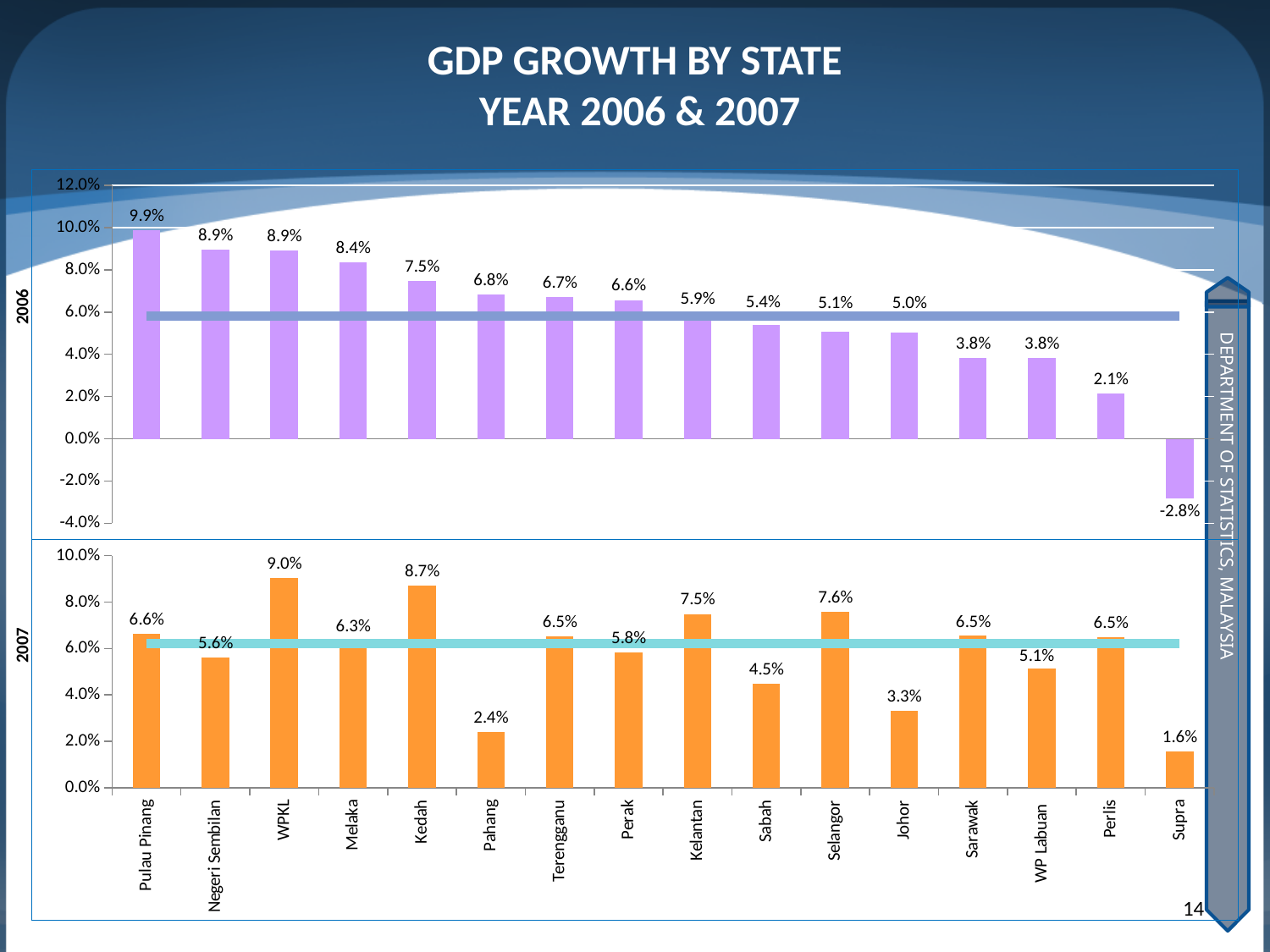
In the 2007 chart, which state has the highest GDP growth? WPKL In the 2006 chart, what is the GDP growth for Pulau Pinang? 9.9% In the 2006 chart, is the value for Sabah greater or less than 6.0%? less In the 2007 chart, which state has the lowest GDP growth? Supra How many states are shown on the x axis of the 2007 chart? 16 In the 2006 chart, do the values generally rise or fall from left to right along the x axis? Fall In the 2007 chart, which is larger, the GDP growth of Selangor or Kelantan? Selangor What type of chart is the 2006 chart? Combination bar and line chart What colour are the bars in the 2007 chart? Orange In the 2007 chart, what is the GDP growth for Kedah? 8.7% In the 2006 chart, which state has the lowest GDP growth? Supra In the 2006 chart, what is the difference between the GDP growth of Pulau Pinang and Melaka? 1.5%